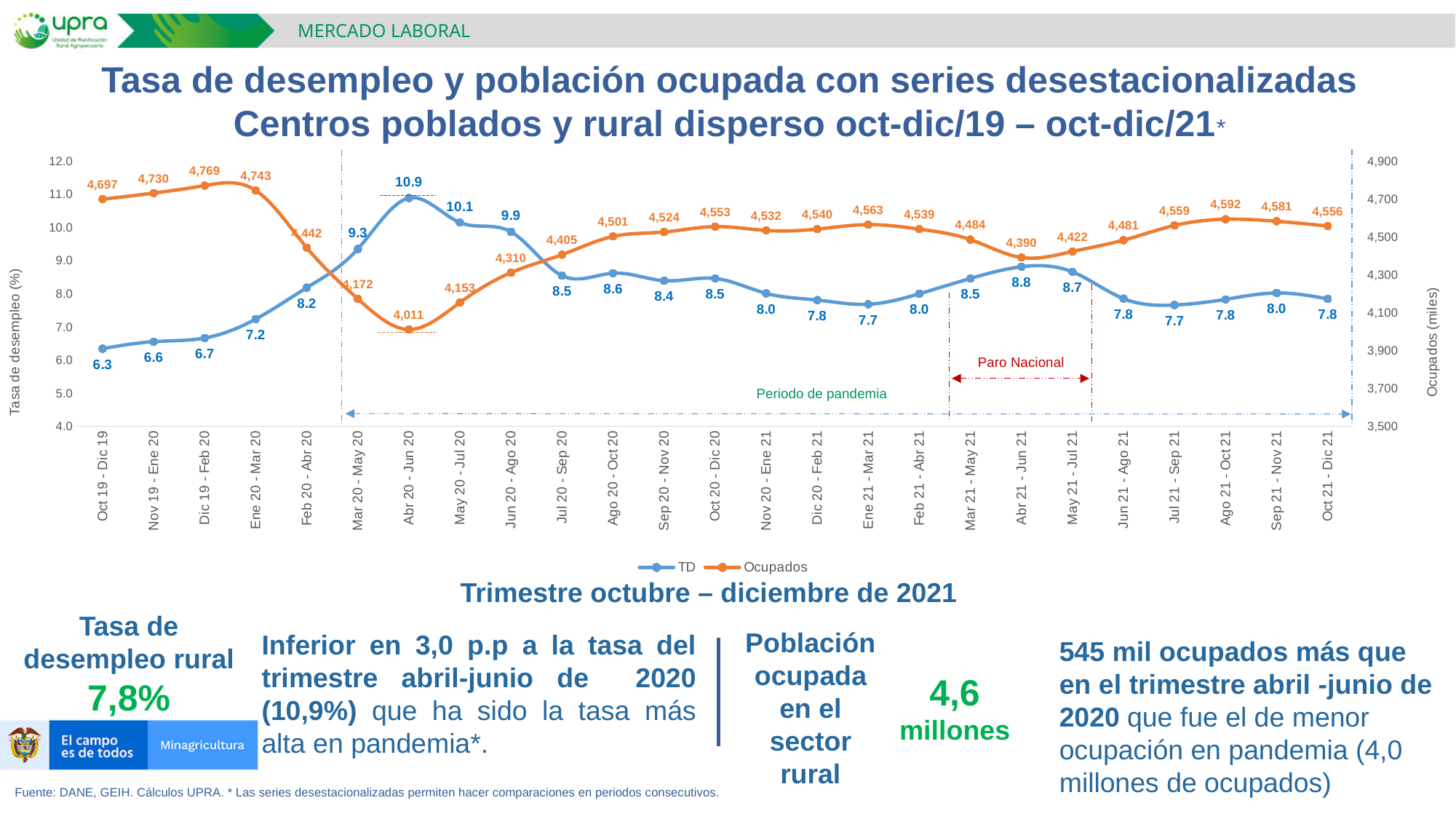
What is the Ocupados value for the period Abr 20 - Jun 20? 4,011 What kind of chart is shown on the slide? Line chart Which series is drawn in orange according to the legend? Ocupados How many series does the chart legend list? 2 What is the Ocupados value for the period Oct 21 - Dic 21? 4,556 What is the difference between the TD value for Abr 20 - Jun 20 and the TD value for Oct 21 - Dic 21? 3.1 What is the TD value for the period Abr 20 - Jun 20? 10.9 In which period does the TD series reach its highest value? Abr 20 - Jun 20 How many periods are shown on the x axis of the chart? 25 Which period has a higher Ocupados value, Ago 21 - Oct 21 or Abr 21 - Jun 21? Ago 21 - Oct 21 In which period does the Ocupados series reach its highest value? Dic 19 - Feb 20 In which period does the TD series have its lowest value? Oct 19 - Dic 19